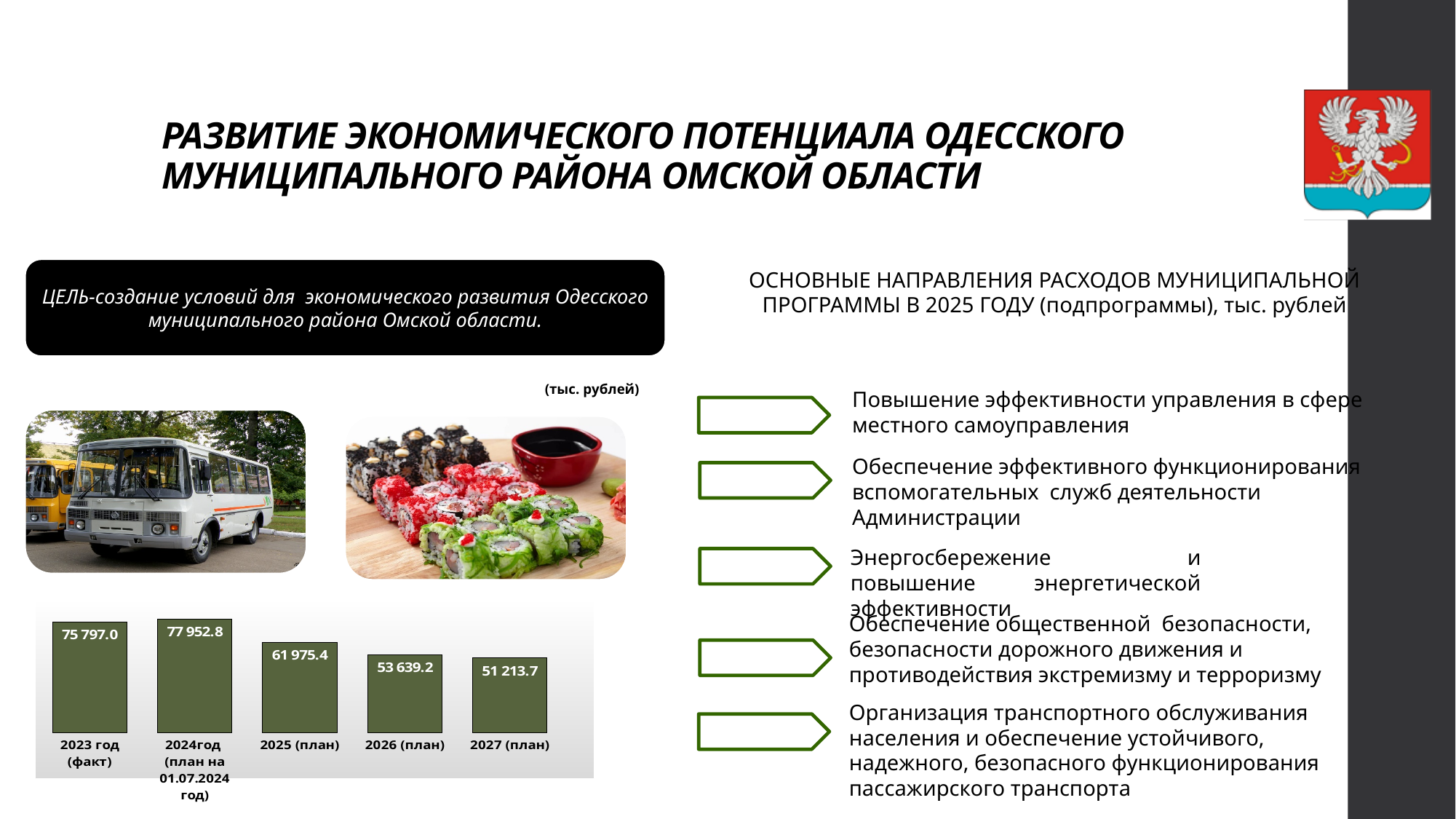
Which category has the highest value? 2024год (план на 01.07.2024 год) What is the value for 2026 (план)? 53 639.2 What kind of chart is shown on the slide? Bar chart What is the value for 2025 (план)? 61 975.4 What is the difference between the values for 2024год (план на 01.07.2024 год) and 2023 год (факт)? 2 155.8 What is the difference between the values for 2025 (план) and 2026 (план)? 8 336.2 What is the value for 2027 (план)? 51 213.7 Which is larger, the value for 2025 (план) or the value for 2027 (план)? 2025 (план) What is the value for 2023 год (факт)? 75 797.0 Do the values rise or fall from 2024год (план на 01.07.2024 год) to 2027 (план)? Fall How many categories are shown in the bar chart? 5 Which category has the lowest value? 2027 (план)